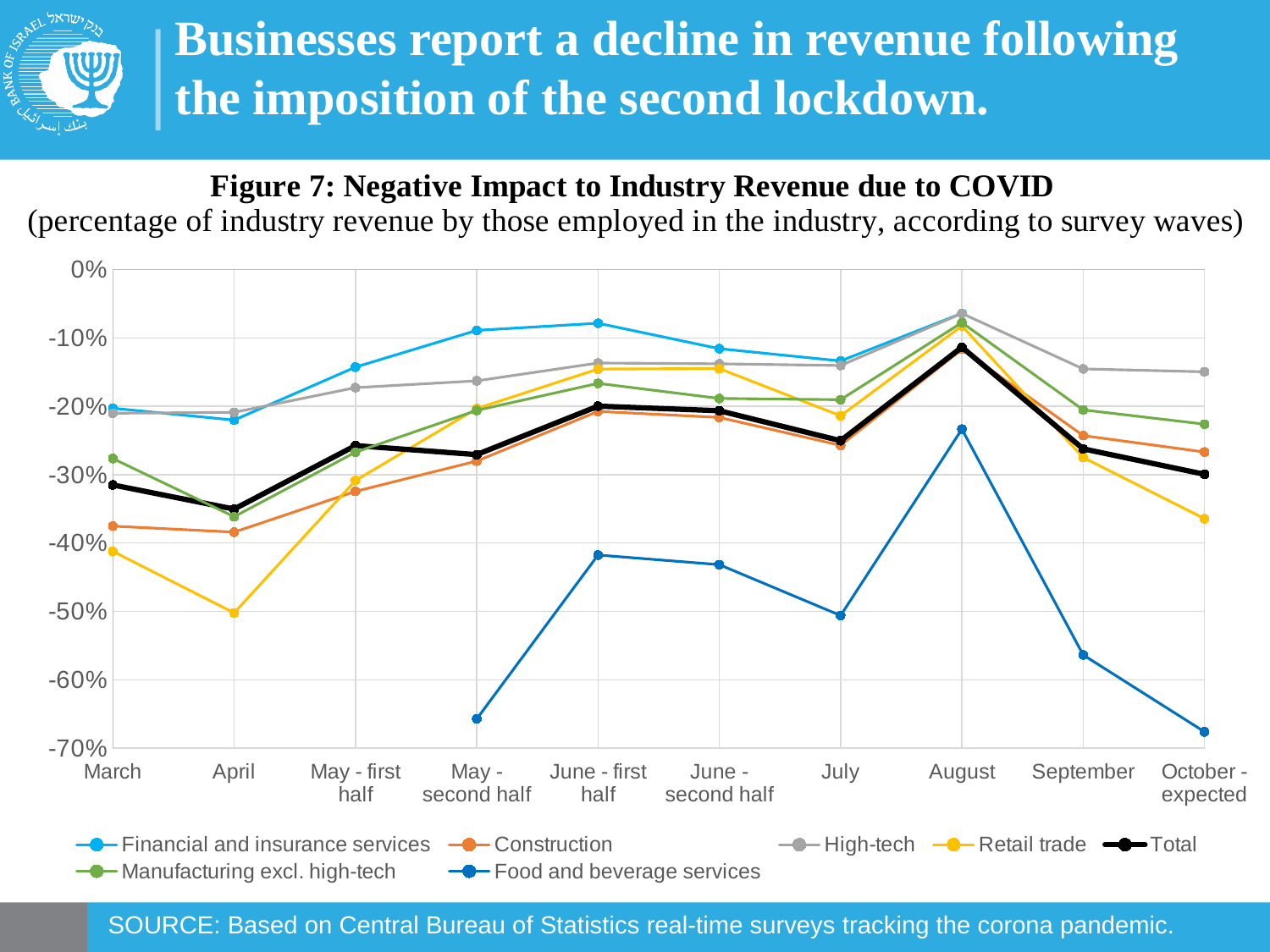
Is the value for Food and beverage services in May - second half greater or less than -60%? less How many series does the legend list? 7 Which series has the lowest value in October - expected? Food and beverage services What kind of chart is shown on the slide? line chart In which survey wave does the Total series reach its highest value? August How many survey-wave categories are shown along the x axis? 10 Which series has the highest value in May - second half? Financial and insurance services Does the Total line rise or fall from August to September? fall Is the value for Retail trade in April greater or less than -40%? less In March, which is higher: Construction or Retail trade? Construction Is the value for Total in August greater or less than -20%? greater